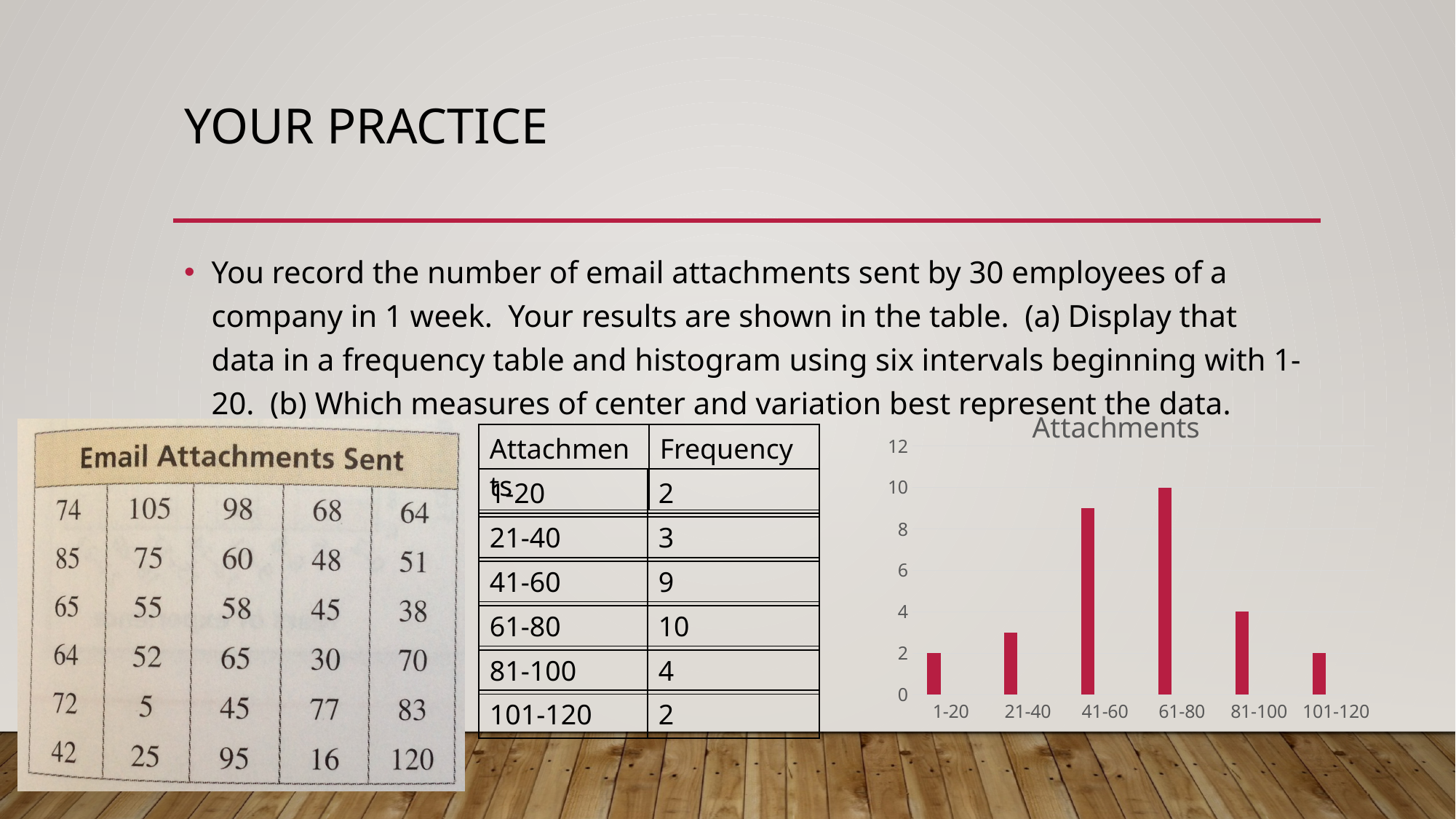
What is the title of the chart? Attachments What kind of chart is shown on the slide? bar chart Is the value for 21-40 greater or less than 4? less Which category has the highest bar in the chart? 61-80 Is the value for 41-60 greater or less than 8? greater What is the difference between the values for 61-80 and 81-100? 6 What is the value for the 61-80 category in the chart? 10 Which is larger, the value for 41-60 or the value for 81-100? 41-60 How many categories are shown on the x axis of the chart? 6 What is the value for the 1-20 category in the chart? 2 Do the values rise or fall from 61-80 to 101-120 along the x axis? fall What is the value for the 81-100 category in the chart? 4